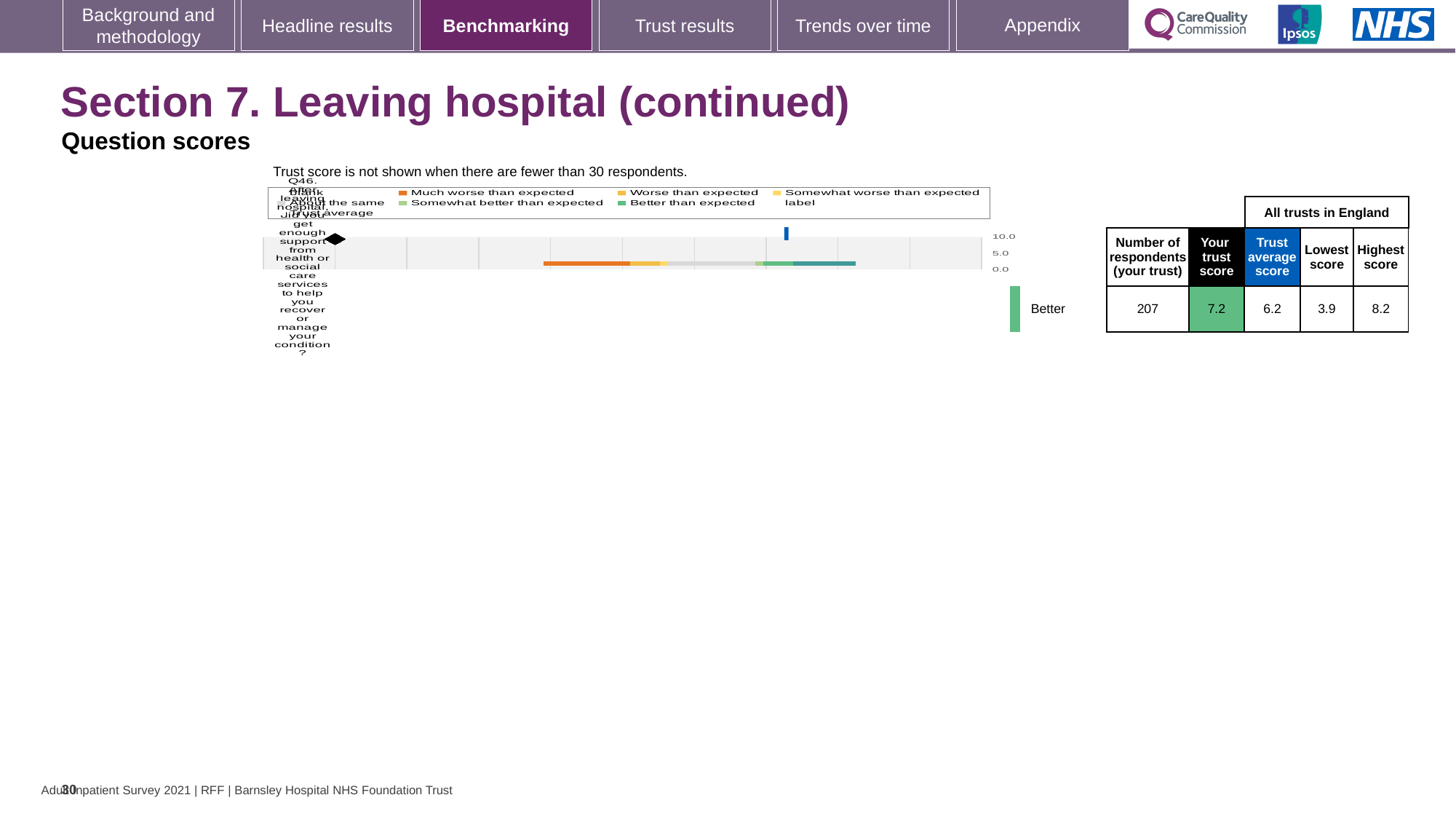
What benchmarking category label is shown next to the chart for Q46? Better Which is larger for Q46: the trust's own score or the trust average score? Your trust score What kind of chart is used to show the Q46 benchmarking result? Bar chart How many respondents from the trust answered Q46? 207 What is the trust score for Q46 shown on the slide? 7.2 What is the trust average score across all trusts in England for Q46? 6.2 What is the lowest score among all trusts in England for Q46? 3.9 How many questions are plotted on the chart on this slide? 1 What is the difference between the trust score and the trust average score for Q46? 1.0 What is the difference between the highest and lowest scores across all trusts in England for Q46? 4.3 Is the trust score for Q46 greater or less than 5.0 on the chart's axis? greater What is the highest score among all trusts in England for Q46? 8.2